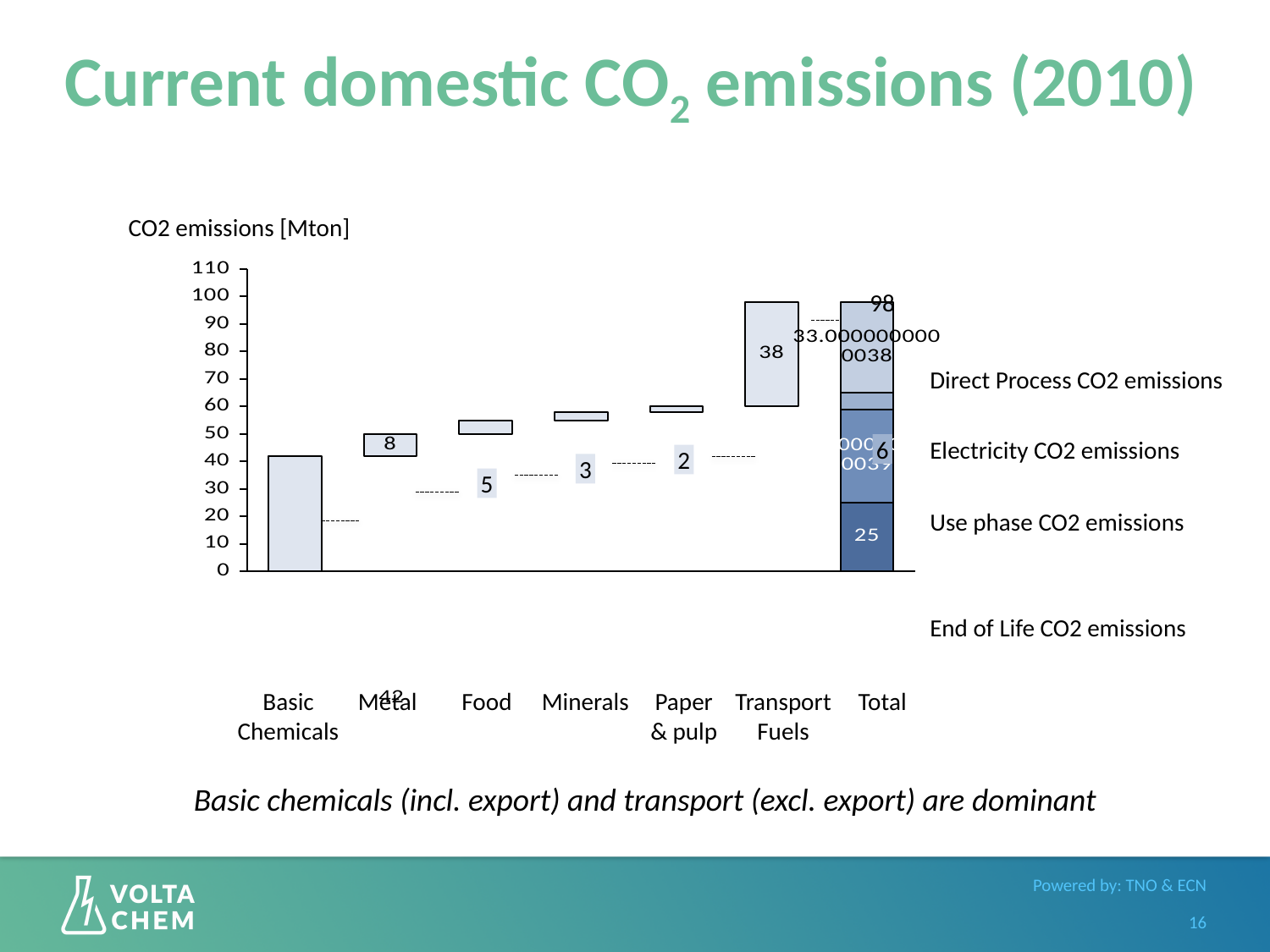
What is the value for Transport Fuels? 38 Which is larger, the value for Food or the value for Minerals? Food What is the value for Food? 5 What is the value of the bottom (darkest) segment of the Total bar? 25 What is the value shown for Total? 98 What is the value for Metal? 8 What is the value for Paper & pulp? 2 What unit is given for CO2 emissions on the chart? Mton Which sector category has the lowest value? Paper & pulp How many categories are shown on the x axis? 7 What is the difference between the values for Transport Fuels and Metal? 30 Which sector category (excluding Total) has the highest value? Basic Chemicals